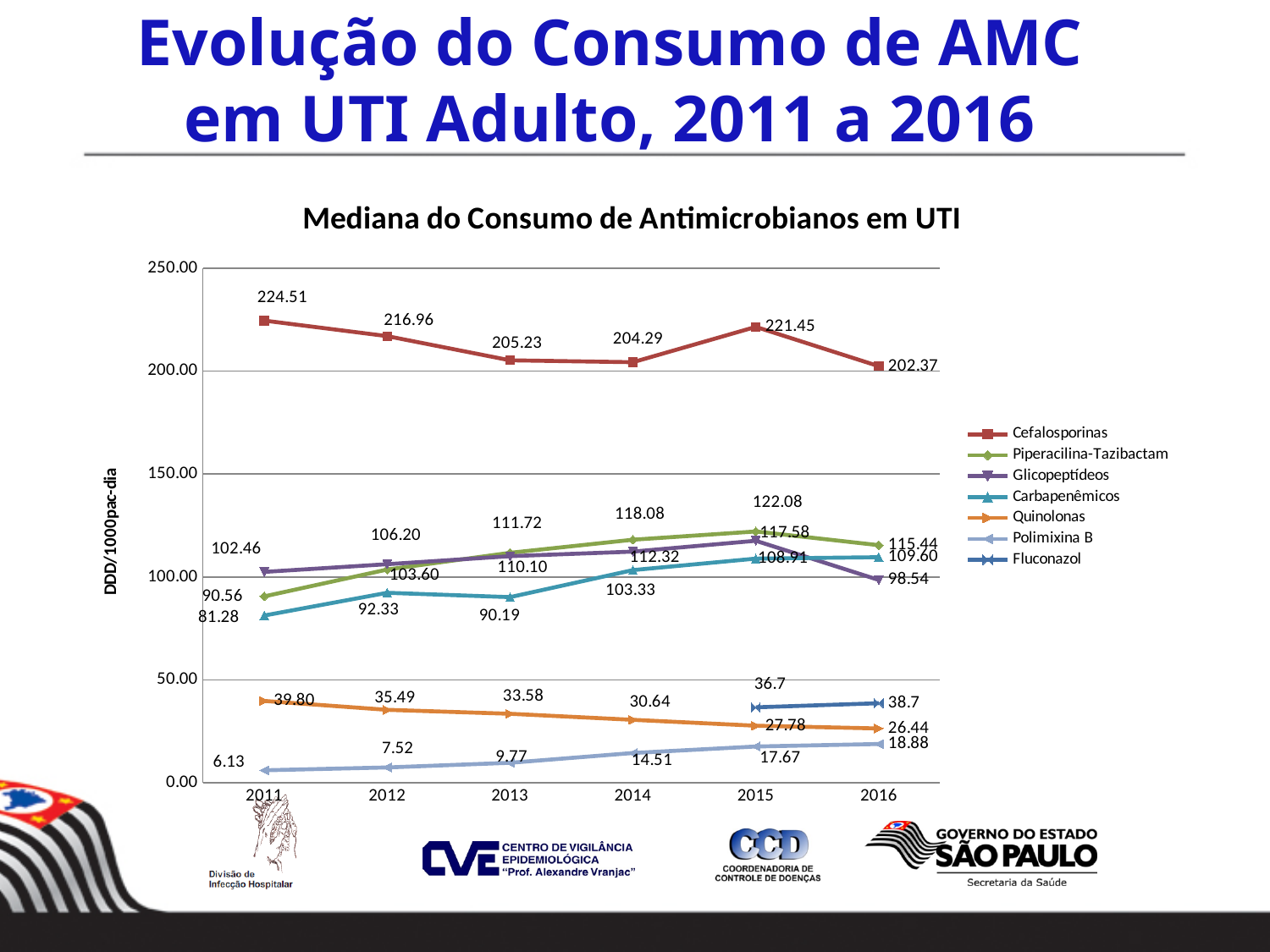
What is the value for Quinolonas in 2011? 39.80 What is the value for Polimixina B in 2016? 18.88 In 2011, which is larger: Quinolonas or Polimixina B? Quinolonas How many series does the legend list? 7 What kind of chart is shown on the slide? line chart What is the value for Cefalosporinas in 2011? 224.51 Do the values for Polimixina B rise or fall from 2011 to 2016? rise In which year is the value for Quinolonas lowest? 2016 In which year is the value for Cefalosporinas highest? 2011 What is the value for Cefalosporinas in 2016? 202.37 What is the difference between the Cefalosporinas values in 2011 and 2016? 22.14 What is the value for Fluconazol in 2016? 38.7